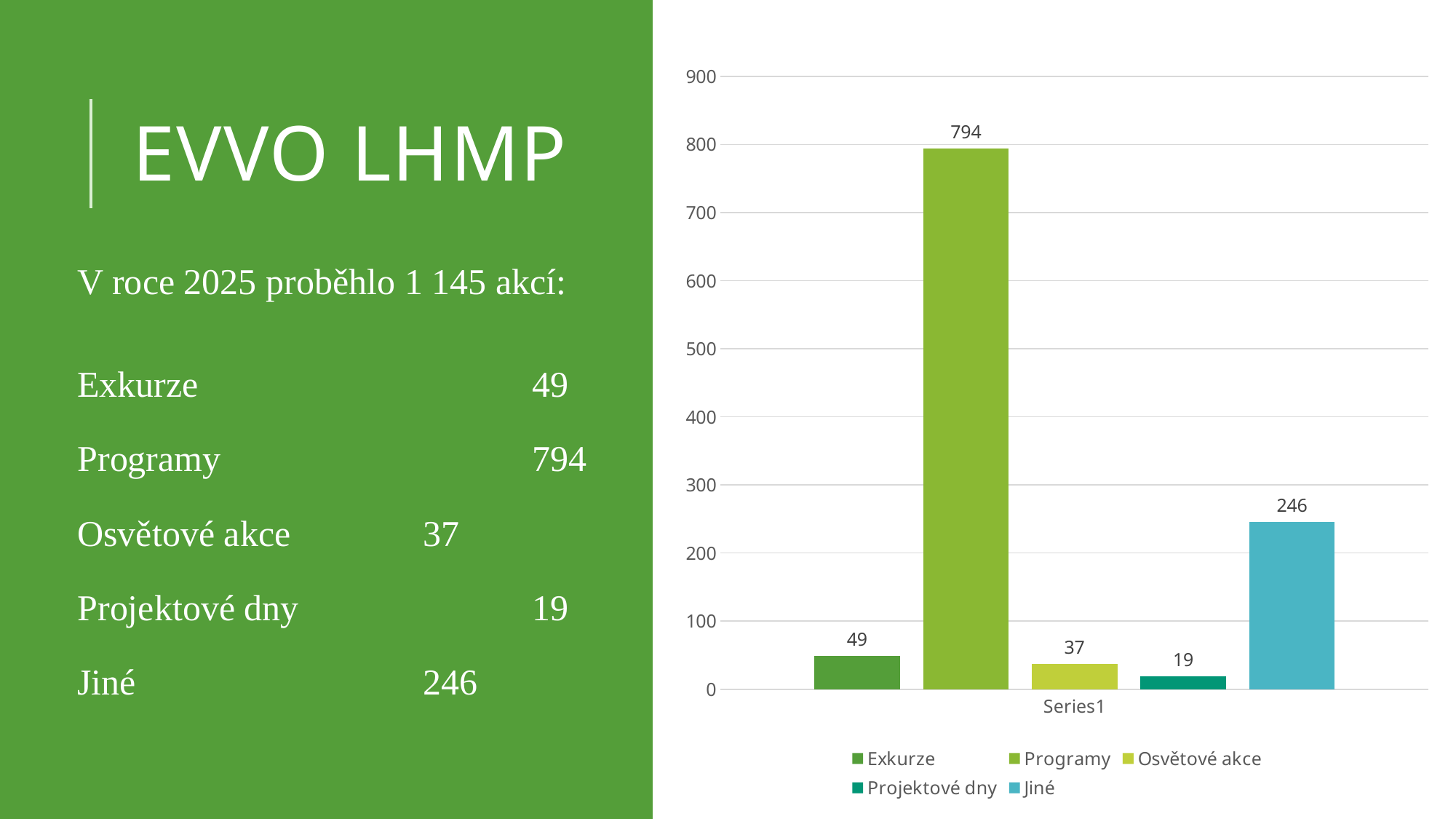
How many entries does the chart legend list? 5 What is the difference between the values for Programy and Jiné? 548 Which is larger, the value for Exkurze or the value for Osvětové akce? Exkurze Which category has the lowest value in the chart? Projektové dny What kind of chart is shown on the slide? bar chart How many bars are shown in the chart? 5 What is the value for Programy in the chart? 794 What is the difference between the values for Exkurze and Osvětové akce? 12 Which category has the highest value in the chart? Programy What is the value for Jiné in the chart? 246 What is the value for Projektové dny in the chart? 19 Is the value for Jiné greater or less than 300? less